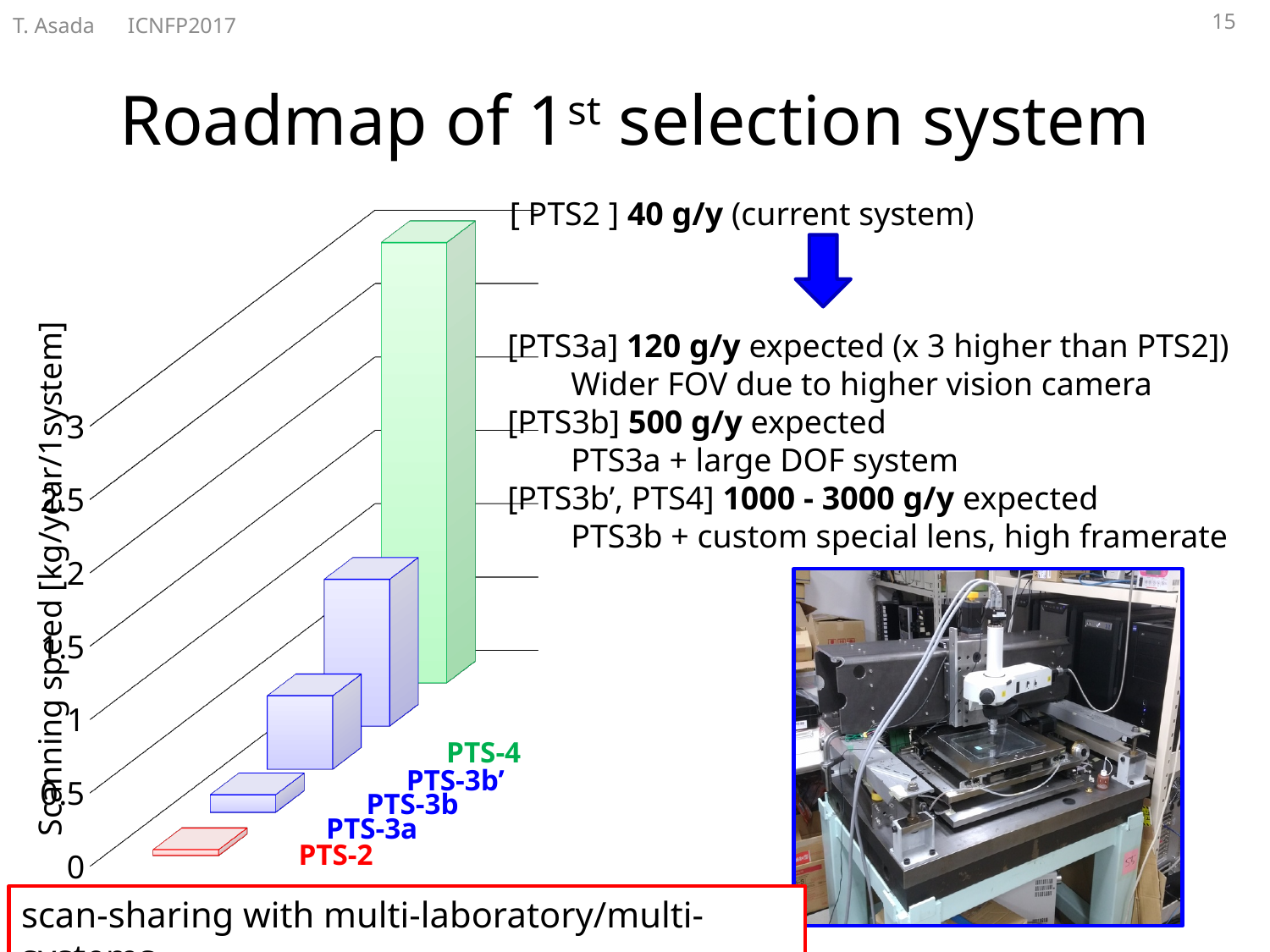
What kind of chart is shown on the slide? bar chart Is the value for PTS-2 greater or less than 0.5? less How many categories (systems) are plotted in the chart? 5 Do the bar values rise or fall from PTS-2 to PTS-4 along the x axis? rise Is the value for PTS-3b' greater or less than 2? less Which system has the lowest scanning speed in the chart? PTS-2 What colour is the bar for PTS-4? green What is the label of the vertical axis of the chart? Scanning speed [kg/year/1system] Is the value for PTS-4 greater or less than 2? greater Which has a larger scanning speed, PTS-3b' or PTS-3a? PTS-3b' Which has a larger scanning speed, PTS-4 or PTS-3b? PTS-4 Which system has the highest scanning speed in the chart? PTS-4